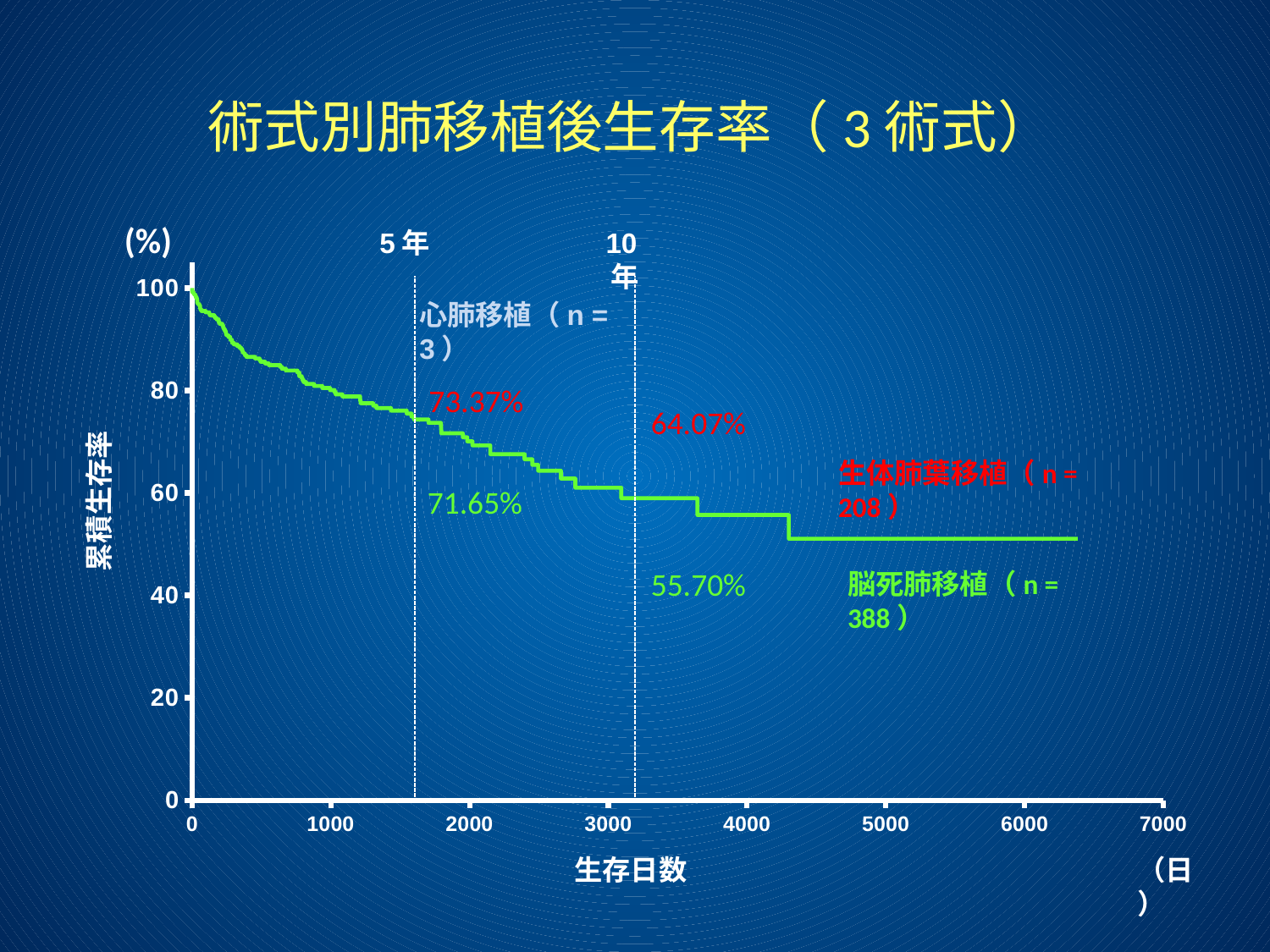
How many patients (n) are in the 脳死肺移植 group according to the slide? 388 What kind of chart is shown on the slide? line chart (survival curve) What is the difference between the 10-year survival rates of 生体肺葉移植 (64.07%) and 脳死肺移植 (55.70%)? 8.37 percentage points At 10 years, which has the higher printed survival rate: 生体肺葉移植 or 脳死肺移植? 生体肺葉移植 What is the 10-year survival rate printed for 生体肺葉移植? 64.07% What is the 5-year survival rate printed for 脳死肺移植? 71.65% What is the title of the chart? 術式別肺移植後生存率（3術式） Does the plotted green survival curve rise or fall as survival days increase? fall What is the 10-year survival rate printed for 脳死肺移植? 55.70% What is the difference between the 5-year survival rates of 生体肺葉移植 (73.37%) and 脳死肺移植 (71.65%)? 1.72 percentage points What is the 5-year survival rate printed for 生体肺葉移植? 73.37% Is the green curve's value at 6000 days greater or less than 60? less